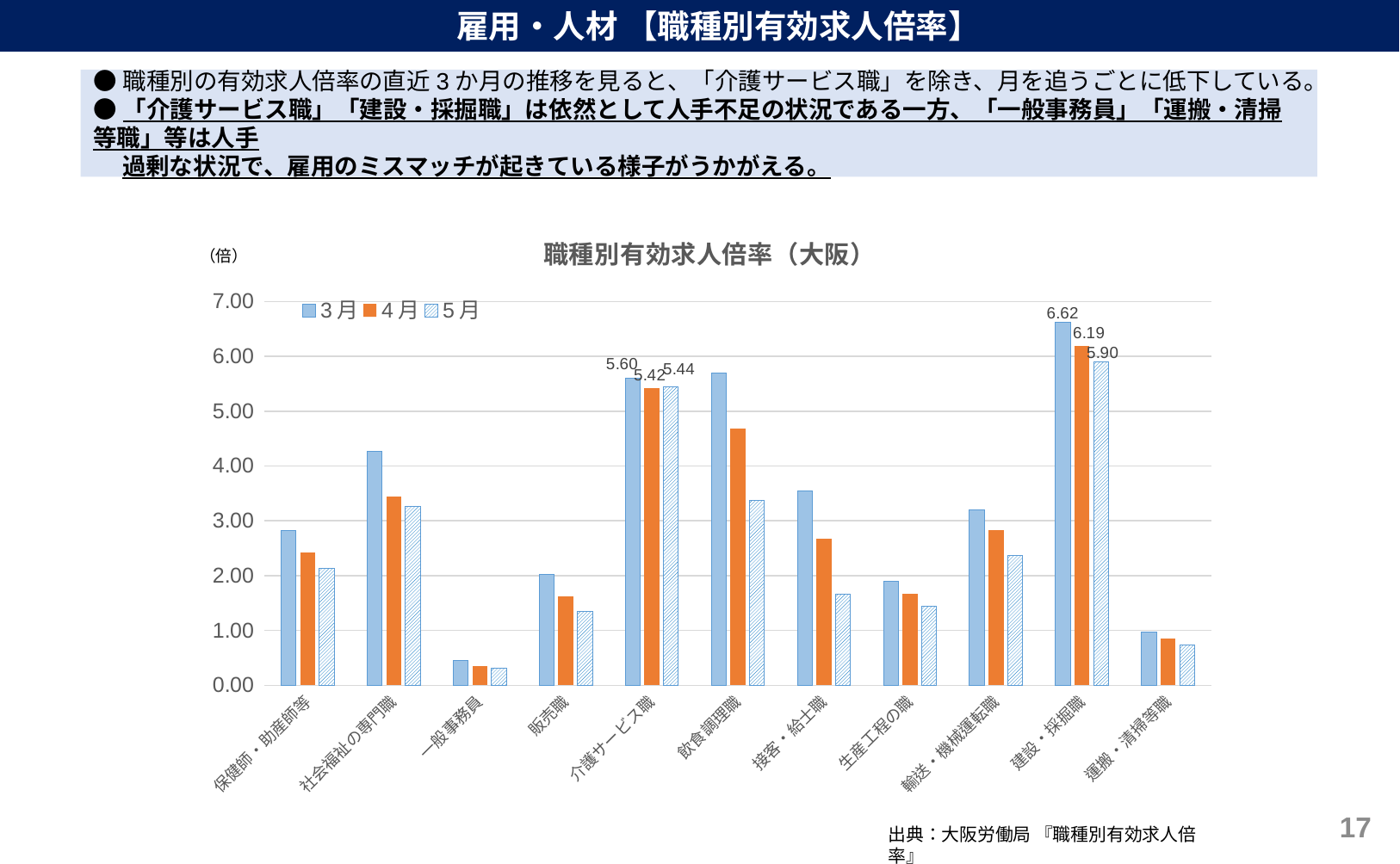
How many occupation categories are shown on the x axis? 11 What is the value for 建設・採掘職 in 5月? 5.90 How many series does the legend list? 3 What is the difference between the 3月 and 5月 values for 建設・採掘職? 0.72 What is the value for 介護サービス職 in 5月? 5.44 What is the difference between the 3月 and 4月 values for 介護サービス職? 0.18 Which occupation has the highest value in 3月? 建設・採掘職 Which occupation has the lowest value in 4月? 一般事務員 What kind of chart is shown on the slide? bar chart Is the value for 社会福祉の専門職 in 3月 greater or less than 4.00? greater What is the value for 建設・採掘職 in 3月? 6.62 Which is larger for 飲食調理職: the 3月 value or the 5月 value? 3月